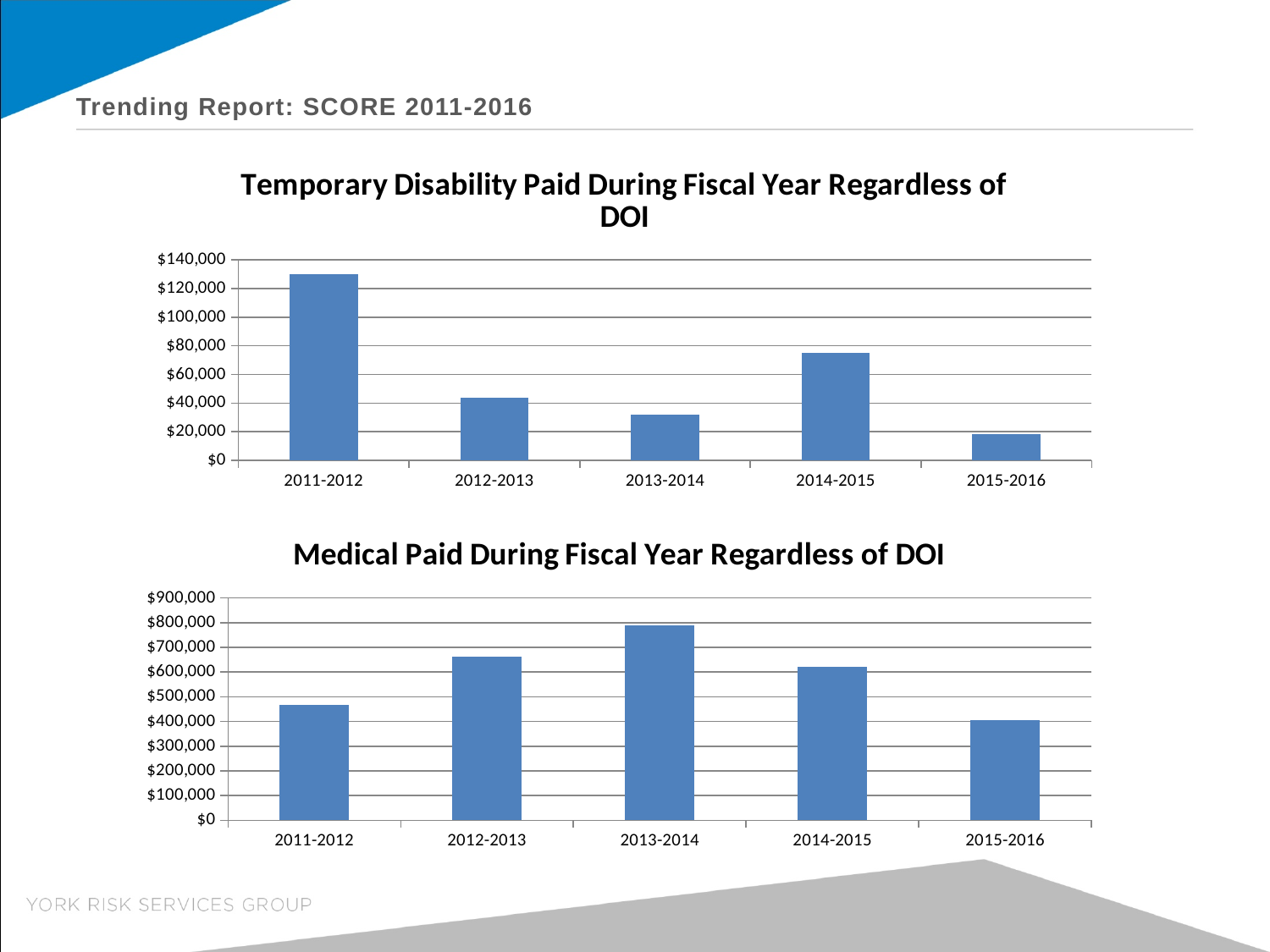
In the Temporary Disability Paid During Fiscal Year Regardless of DOI chart, is the value for 2011-2012 greater or less than $120,000? greater In the Temporary Disability Paid During Fiscal Year Regardless of DOI chart, is the value for 2014-2015 greater or less than $60,000? greater In the Temporary Disability Paid During Fiscal Year Regardless of DOI chart, which is larger, the value for 2012-2013 or 2014-2015? 2014-2015 How many fiscal years are shown in the Medical Paid During Fiscal Year Regardless of DOI chart? 5 In the Medical Paid During Fiscal Year Regardless of DOI chart, is the value for 2011-2012 greater or less than $500,000? less What type of chart is the Temporary Disability Paid During Fiscal Year Regardless of DOI chart? Bar chart In the Temporary Disability Paid During Fiscal Year Regardless of DOI chart, which fiscal year has the highest value? 2011-2012 In the Medical Paid During Fiscal Year Regardless of DOI chart, which fiscal year has the lowest value? 2015-2016 In the Medical Paid During Fiscal Year Regardless of DOI chart, which fiscal year has the highest value? 2013-2014 In the Temporary Disability Paid During Fiscal Year Regardless of DOI chart, which fiscal year has the lowest value? 2015-2016